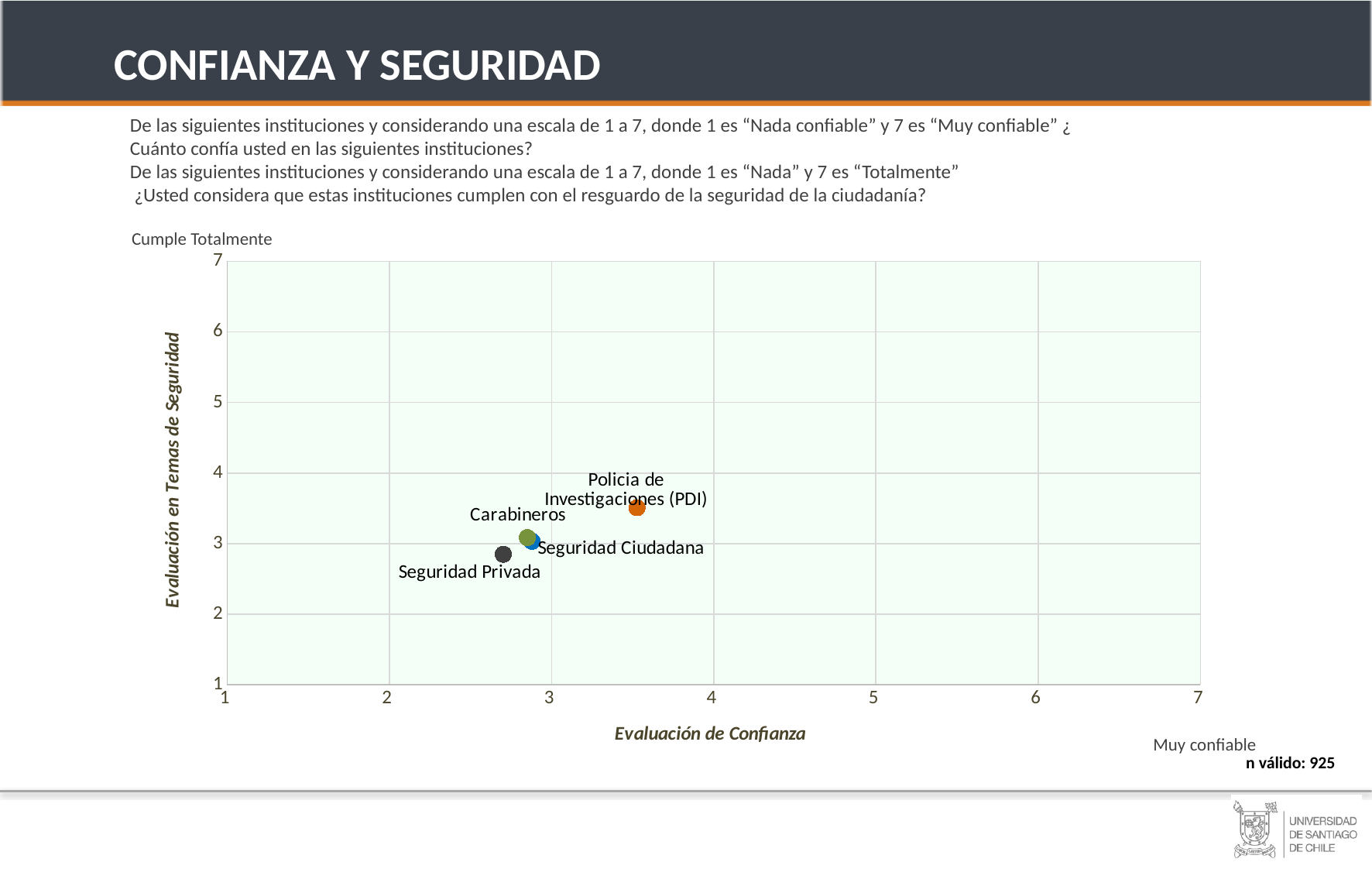
Which institution has the highest value on the Evaluación de Confianza axis? Policia de Investigaciones (PDI) Which institution has the lowest value on the Evaluación de Confianza axis? Seguridad Privada Is the Evaluación de Confianza value for Seguridad Privada greater or less than 3? less What is the title of the horizontal axis of the chart? Evaluación de Confianza What is the title of the vertical axis of the chart? Evaluación en Temas de Seguridad Is the Evaluación de Confianza value for Policia de Investigaciones (PDI) greater or less than 4? less What kind of chart is shown on the slide? scatter chart Which institution has the lowest value on the Evaluación en Temas de Seguridad axis? Seguridad Privada Is the Evaluación de Confianza value for Policia de Investigaciones (PDI) greater or less than 3? greater Which has a higher Evaluación de Confianza value, Policia de Investigaciones (PDI) or Seguridad Privada? Policia de Investigaciones (PDI) Which institution has the highest value on the Evaluación en Temas de Seguridad axis? Policia de Investigaciones (PDI) How many institutions are plotted on the chart? 4